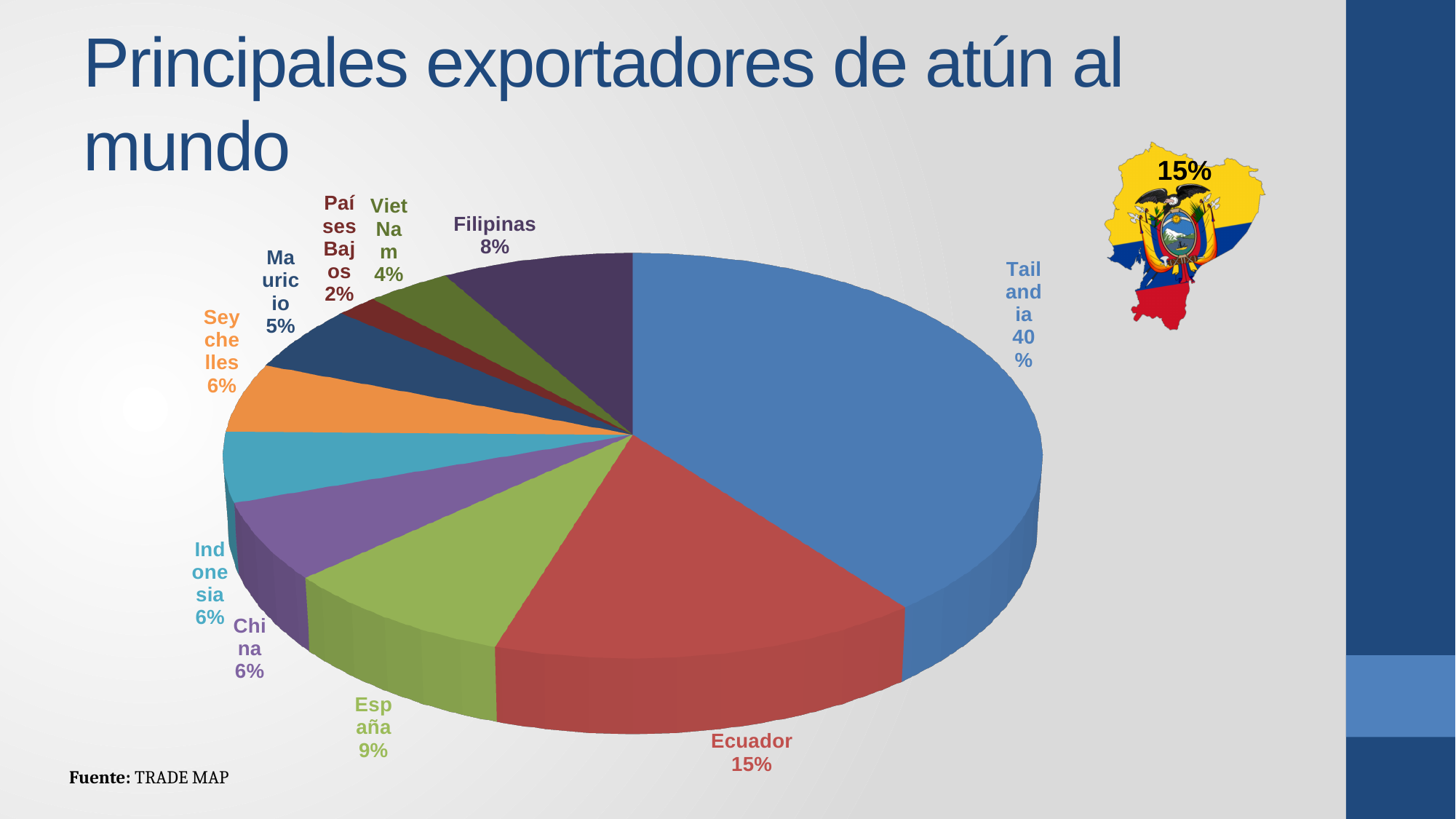
Which country has the smallest slice of the pie? Países Bajos What is the value shown for España? 9% What share of the pie does Ecuador hold? 15% What share of the pie does Tailandia hold? 40% How many slices does the pie chart have? 10 What kind of chart is shown on the slide? pie chart What is the value shown for Viet Nam? 4% Which is larger, the share for Filipinas or the share for Mauricio? Filipinas What is the value shown for Filipinas? 8% What is the difference between the shares of Tailandia and Ecuador? 25% What is the title of the slide containing the chart? Principales exportadores de atún al mundo Which country has the largest slice of the pie? Tailandia